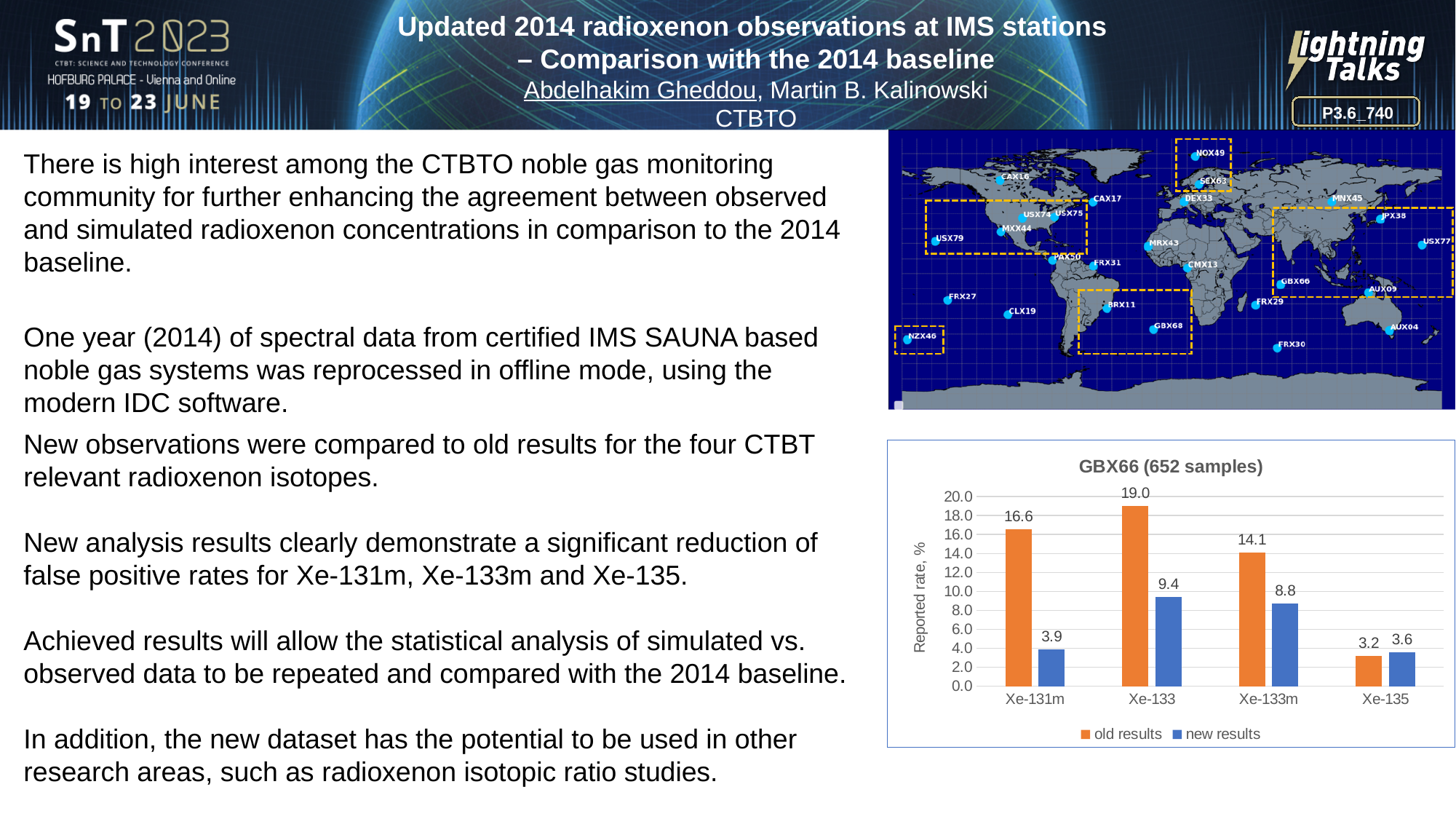
What is the difference between the old and new results for Xe-131m in the GBX66 chart? 12.7 What is the old results value for Xe-131m in the GBX66 chart? 16.6 In the GBX66 chart, which is larger for Xe-135: old results or new results? new results What is the title of the chart on the slide? GBX66 (652 samples) What is the new results value for Xe-135 in the GBX66 chart? 3.6 Which isotope has the highest old results value in the GBX66 chart? Xe-133 What is the difference between the old and new results for Xe-133m in the GBX66 chart? 5.3 What type of chart is the GBX66 chart? bar chart What is the new results value for Xe-133 in the GBX66 chart? 9.4 How many isotope categories are shown on the x axis of the GBX66 chart? 4 How many series does the legend of the GBX66 chart list? 2 Which isotope has the lowest new results value in the GBX66 chart? Xe-135